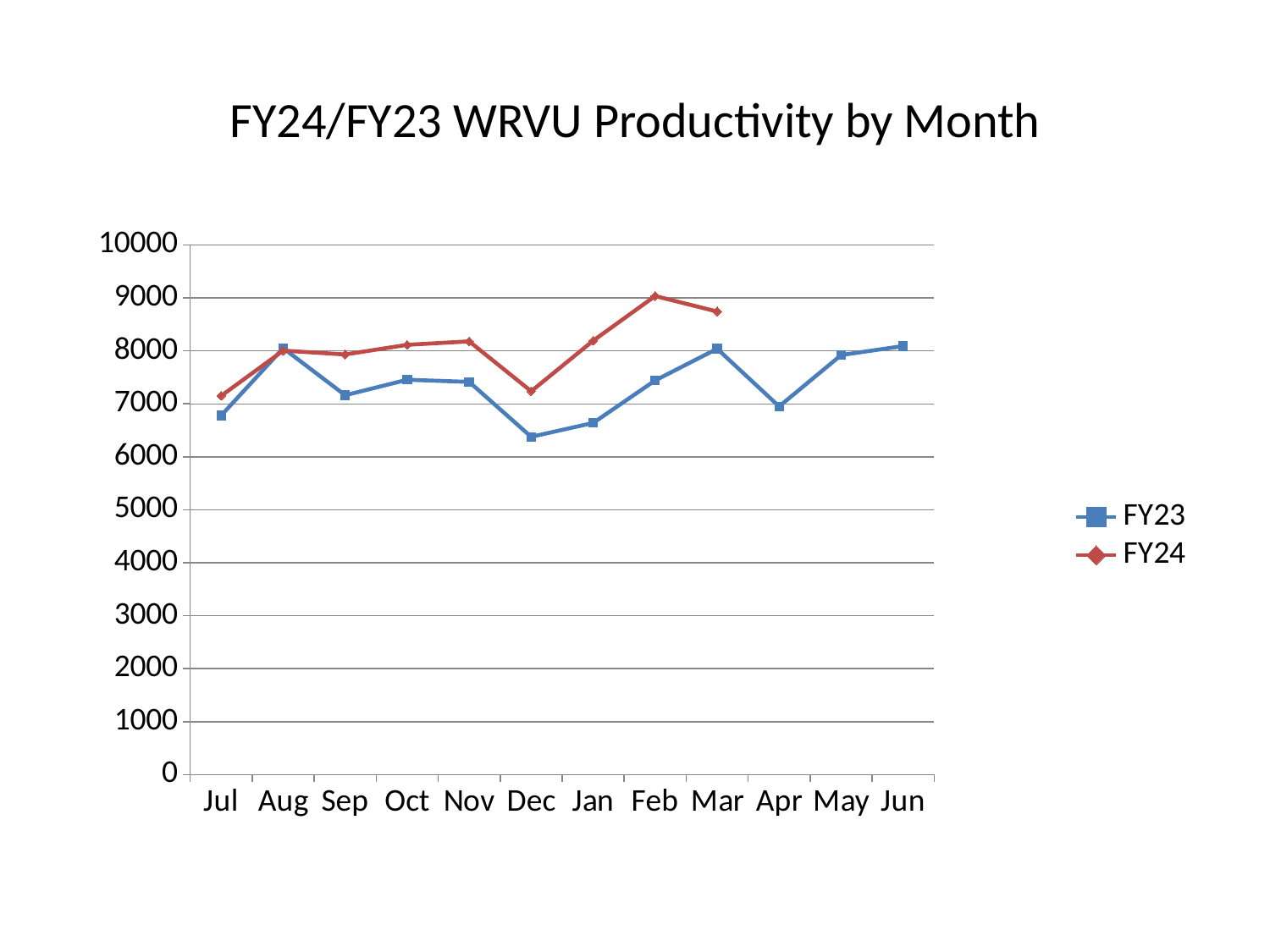
In which month does the FY23 series reach its lowest value? Dec What type of chart is shown on the slide? line chart How many months are shown on the x axis? 12 What is the title of the chart? FY24/FY23 WRVU Productivity by Month Is the FY23 value for Dec greater or less than 7000? less Does the FY24 series rise or fall from Dec to Feb? rise In Jan, which series has the higher value, FY23 or FY24? FY24 How many series does the legend list? 2 How many data points does the FY24 series have? 9 In which month does the FY24 series reach its highest value? Feb Is the FY24 value for Nov greater or less than 8000? greater